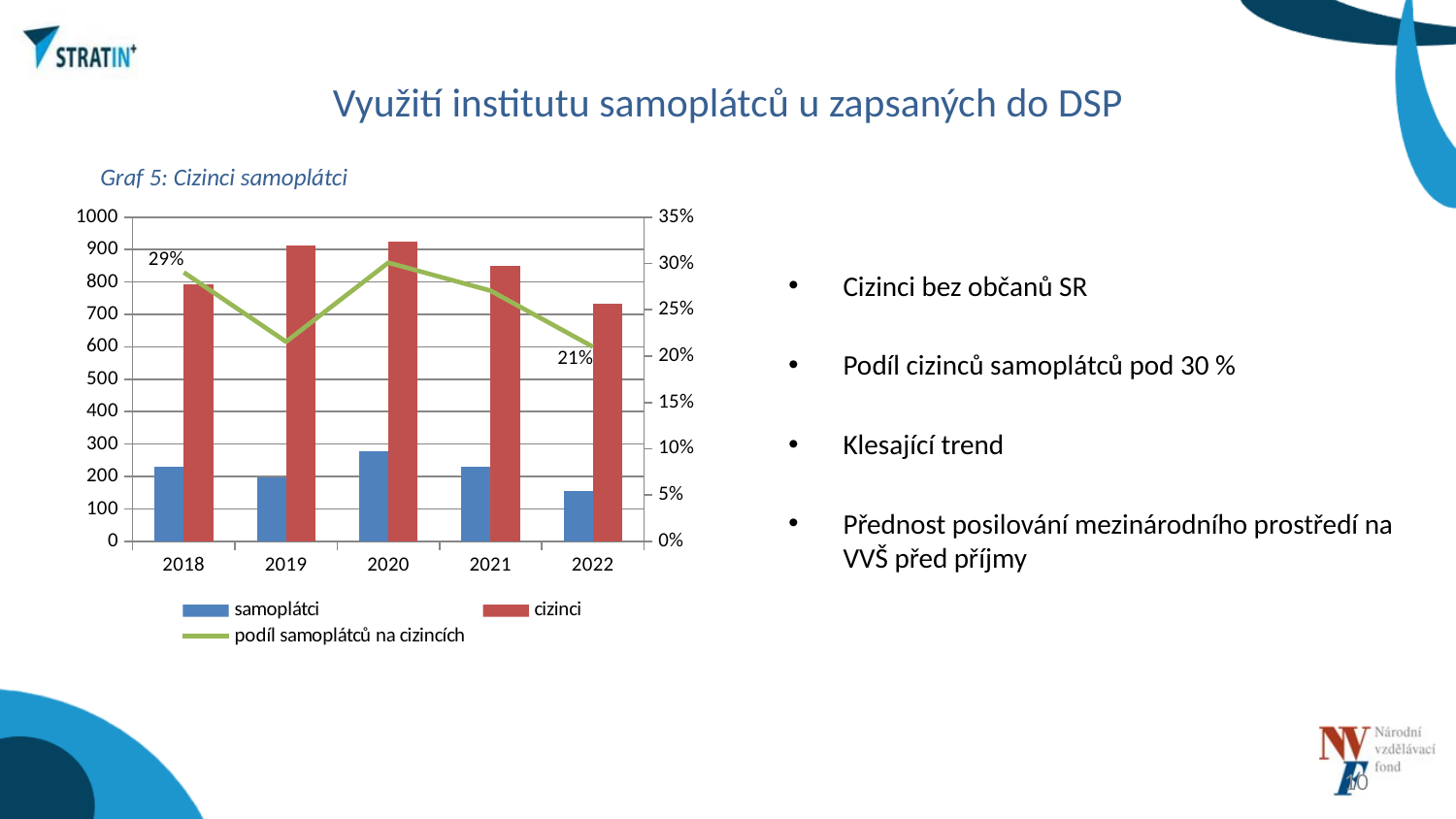
How many series does the chart legend list? 3 What is the value of the 'podíl samoplátců na cizincích' line for 2022? 21% What is the value of the 'podíl samoplátců na cizincích' line for 2018? 29% Is the 'samoplátci' value for 2022 greater or less than 200? less In which year is the 'cizinci' bar the lowest? 2022 By how many percentage points did the share 'podíl samoplátců na cizincích' fall between 2018 and 2022? 8 percentage points What is the title of the chart? Graf 5: Cizinci samoplátci In which year is the 'samoplátci' bar the lowest? 2022 Is the 'cizinci' value for 2020 greater or less than 900? greater How many years are shown on the x axis of the chart? 5 In which year is the 'samoplátci' bar the highest? 2020 Which year has a larger 'cizinci' value, 2021 or 2022? 2021